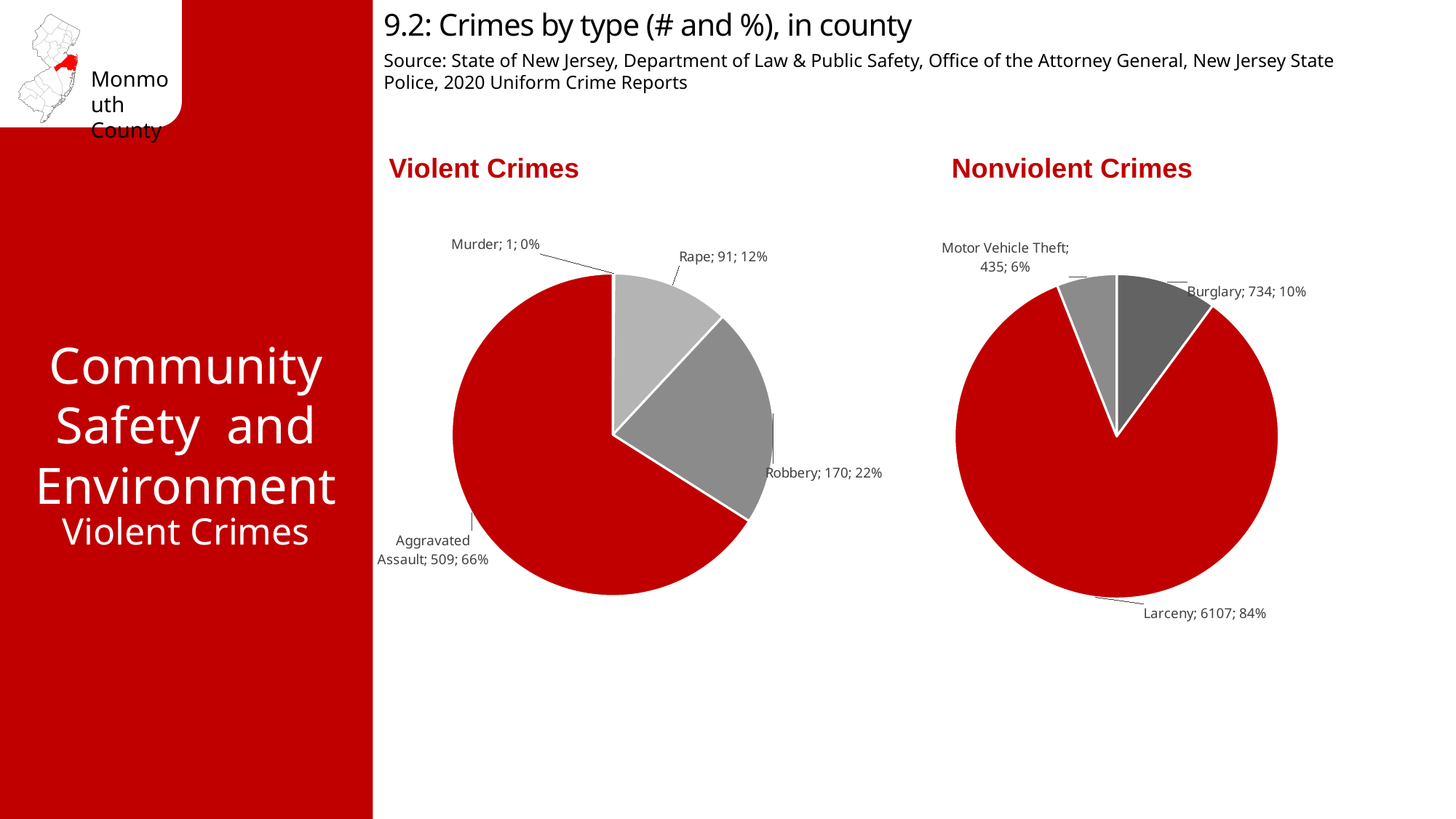
In the Nonviolent Crimes pie chart, what percentage share does Motor Vehicle Theft have? 6% What is the title of the chart on the right side of the slide? Nonviolent Crimes What type of chart is used for the Nonviolent Crimes data? Pie chart In the Nonviolent Crimes pie chart, how many larcenies are shown? 6107 In the Violent Crimes pie chart, how many categories are shown? 4 In the Violent Crimes pie chart, what is the difference between the number of robberies and the number of rapes? 79 In the Nonviolent Crimes pie chart, what is the difference between the number of burglaries and the number of motor vehicle thefts? 299 In the Violent Crimes pie chart, which category has the smallest slice? Murder In the Violent Crimes pie chart, how many aggravated assaults are shown? 509 In the Violent Crimes pie chart, which category has the largest slice? Aggravated Assault In the Nonviolent Crimes pie chart, which is larger, Burglary or Motor Vehicle Theft? Burglary In the Violent Crimes pie chart, what percentage share does Robbery have? 22%